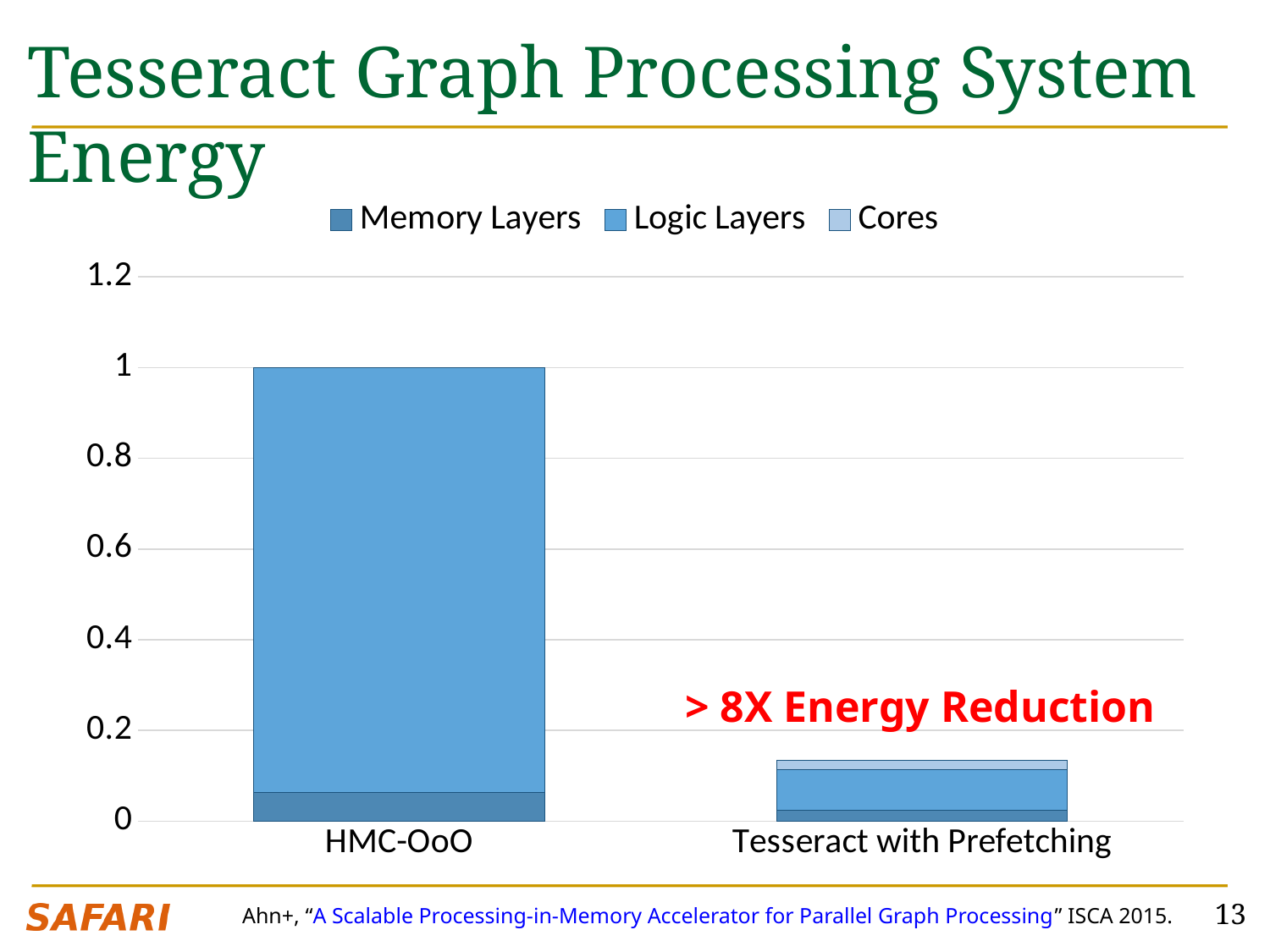
What energy reduction does the red annotation on the chart claim? > 8X Energy Reduction What is the total height of the HMC-OoO stacked bar? 1 Which category has the highest total energy? HMC-OoO Is the total value for HMC-OoO greater or less than 0.8? greater Which category has the lowest total energy? Tesseract with Prefetching Which series are listed in the legend? Memory Layers, Logic Layers, Cores How many categories are shown on the x axis? 2 How many series does the legend list? 3 Do the total values rise or fall from left to right along the x axis? fall What kind of chart is shown on the slide? stacked bar chart Is the total value for Tesseract with Prefetching greater or less than 0.2? less Which is larger, the total for HMC-OoO or the total for Tesseract with Prefetching? HMC-OoO